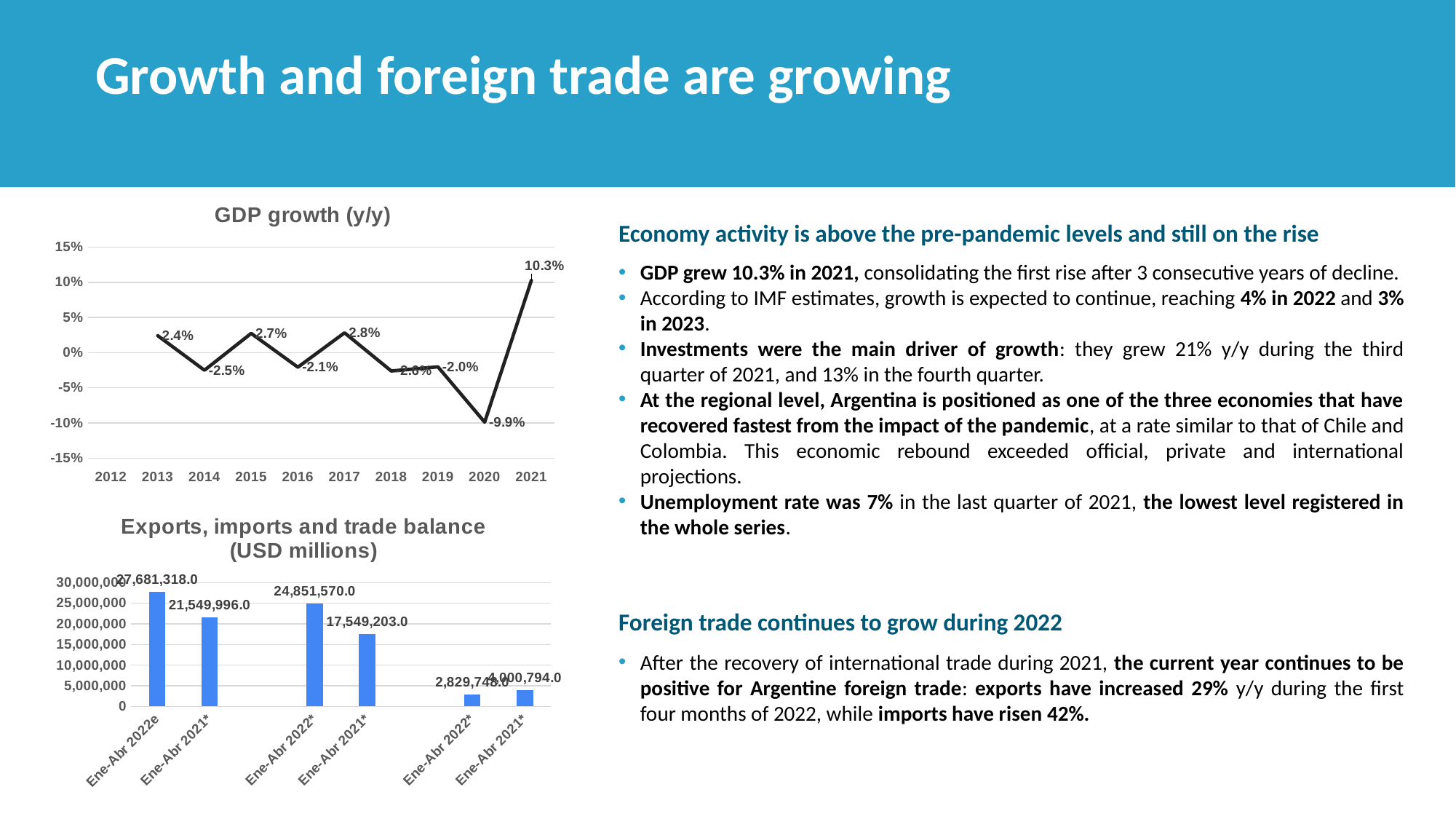
In the GDP growth (y/y) chart, which year has the highest GDP growth? 2021 In the GDP growth (y/y) chart, what is the GDP growth value for 2020? -9.9% In the GDP growth (y/y) chart, what is the GDP growth value for 2021? 10.3% In the GDP growth (y/y) chart, does the line rise or fall from 2017 to 2020? Fall In the Exports, imports and trade balance (USD millions) chart, what is the value of the first bar (Ene-Abr 2022e)? 27,681,318.0 What kind of chart is the GDP growth (y/y) chart? Line chart In the Exports, imports and trade balance (USD millions) chart, how many bars are plotted? 6 In the GDP growth (y/y) chart, which year has the larger value, 2013 or 2014? 2013 In the Exports, imports and trade balance (USD millions) chart, is the value of the last bar on the right greater or less than 5,000,000? less In the GDP growth (y/y) chart, what is the difference in percentage points between the 2021 value and the 2020 value? 20.2 percentage points In the GDP growth (y/y) chart, which year has the lowest GDP growth? 2020 In the Exports, imports and trade balance (USD millions) chart, what is the difference between the first bar (27,681,318.0) and the second bar (21,549,996.0)? 6,131,322.0